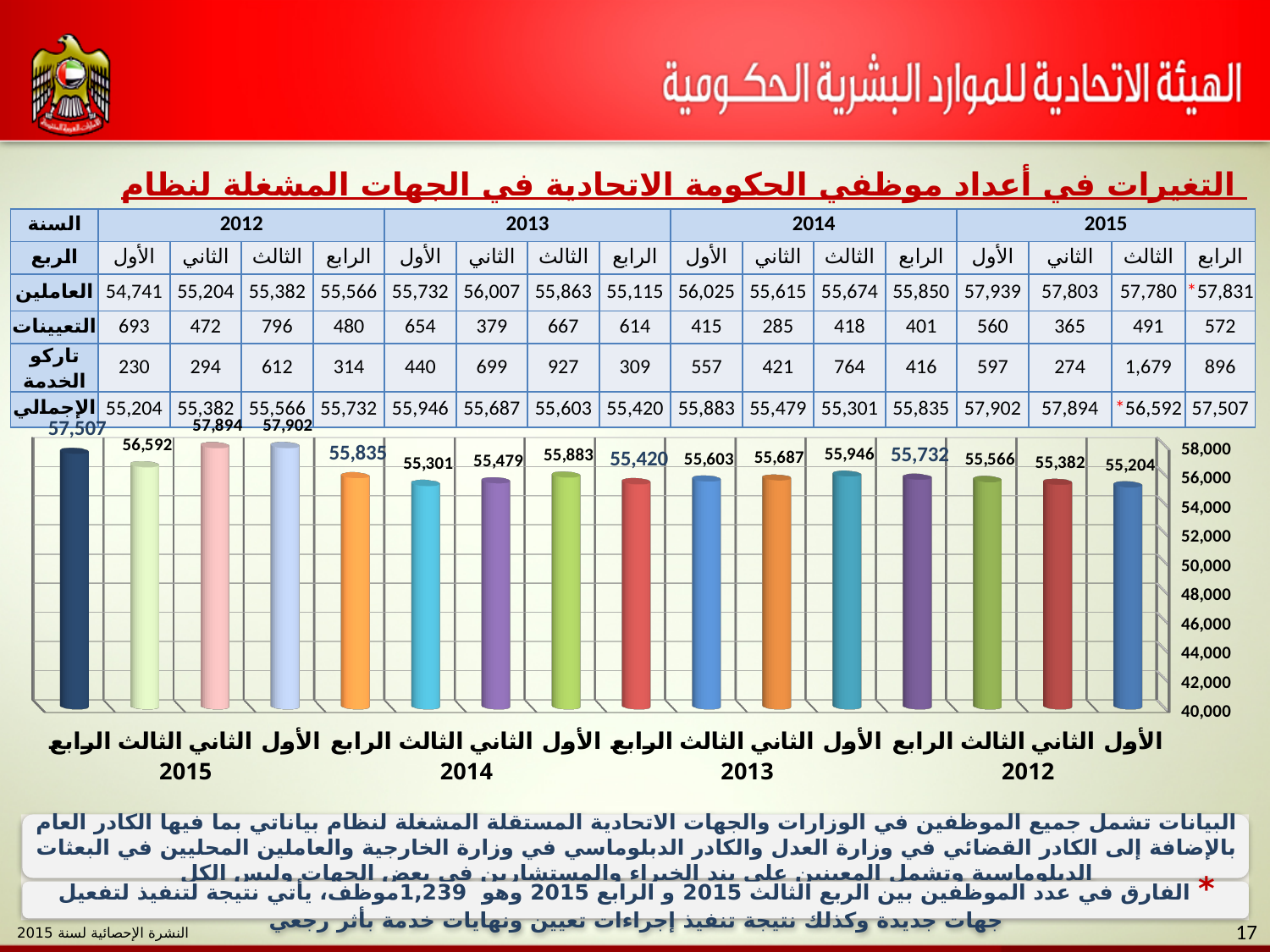
What is the value of the bar for the third quarter (الثالث) of 2015? 56,592 Which quarter has the highest bar in the chart? First quarter (الأول) of 2015 What is the value of the bar for the first quarter (الأول) of 2012? 55,204 What is the difference between the bar for the fourth quarter of 2015 (57,507) and the third quarter of 2015 (56,592)? 915 What kind of chart is shown below the table on the slide? bar chart What is the value of the bar for the first quarter (الأول) of 2015? 57,902 How many bars are plotted in the chart? 16 Is the value for the second quarter (الثاني) of 2015 greater or less than 56,000? greater Which is larger: the bar for the first quarter of 2013 or the bar for the first quarter of 2014? First quarter of 2013 (55,946) What is the value of the bar for the fourth quarter (الرابع) of 2014? 55,835 Which quarter has the lowest bar in the chart? First quarter (الأول) of 2012 What is the highest value shown on the chart's vertical axis? 58,000